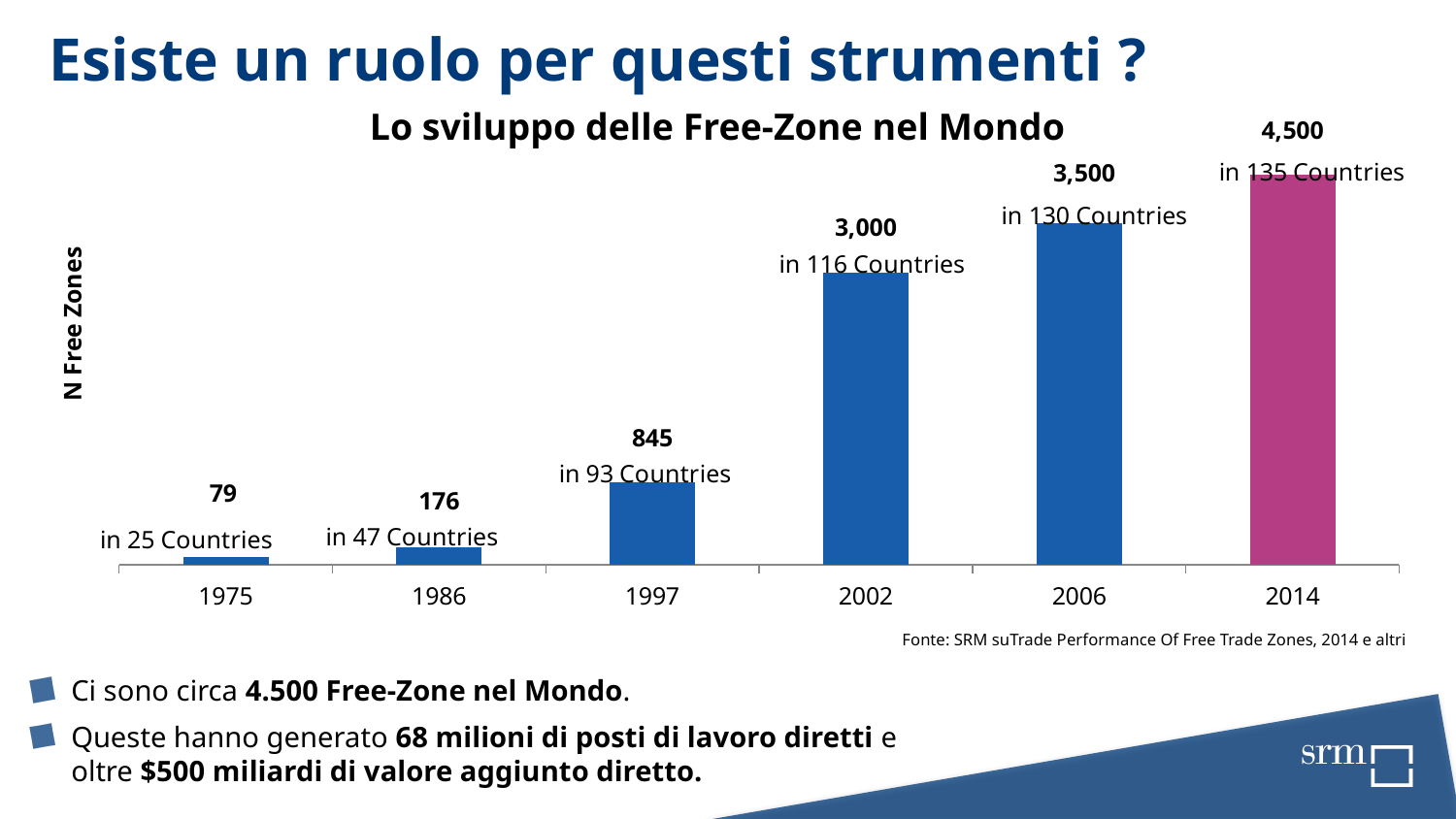
What is the number of free zones shown for 1986? 176 Do the number of free zones rise or fall from 1975 to 2014? Rise Which year has more free zones, 2002 or 2006? 2006 What is the number of free zones shown for 2002? 3,000 What is the title of the chart? Lo sviluppo delle Free-Zone nel Mondo In how many countries were free zones located in 1997, according to the chart? 93 Which year has the lowest number of free zones? 1975 Which year has the highest number of free zones? 2014 What is the difference in the number of free zones between 2014 and 2006? 1,000 How many years are shown on the x axis of the chart? 6 What kind of chart is used to show the development of free zones? Bar chart What is the difference in the number of free zones between 1997 and 1986? 669